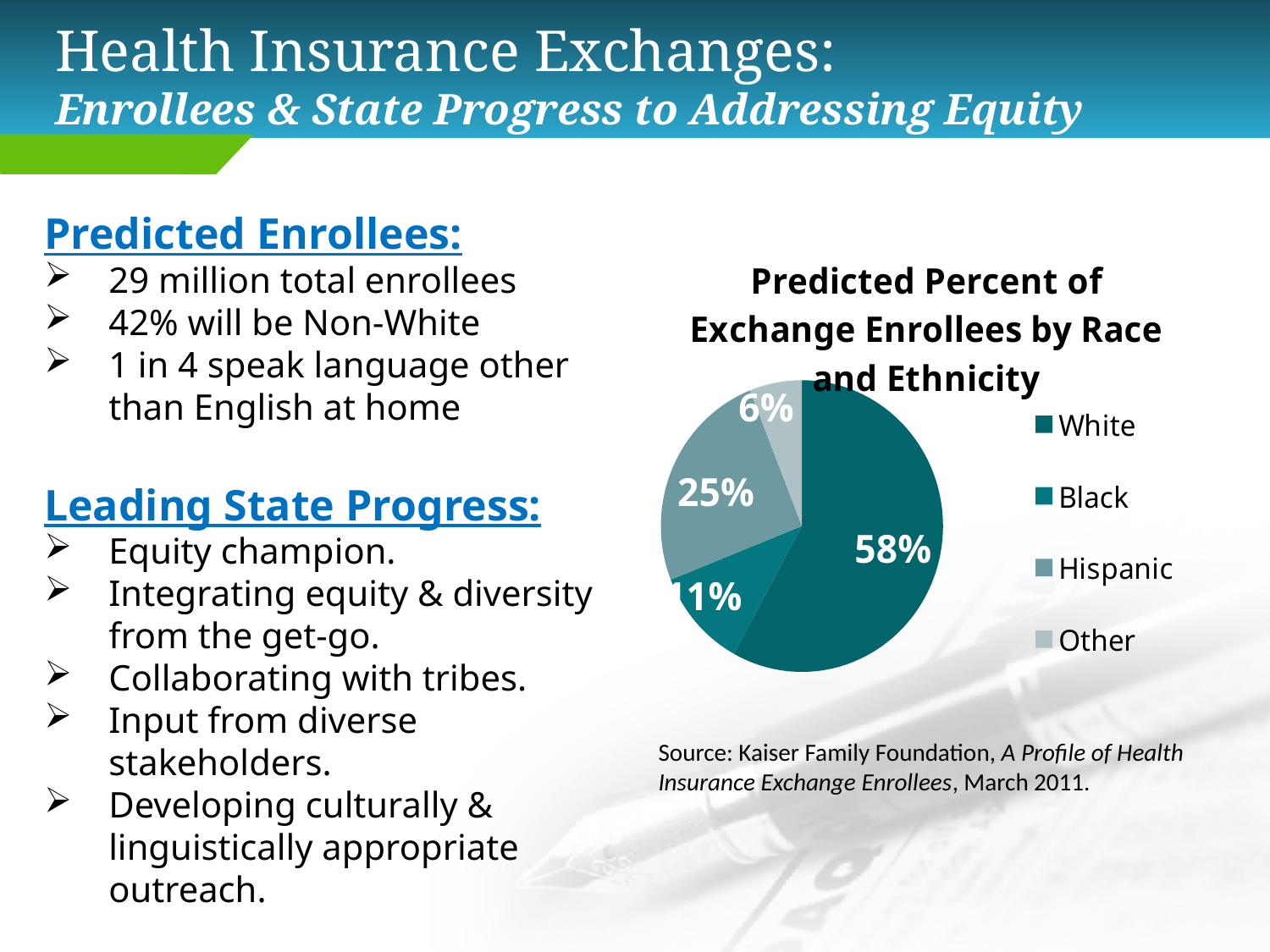
What is the title of the chart on the slide? Predicted Percent of Exchange Enrollees by Race and Ethnicity How many entries does the pie chart legend list? 4 Which race/ethnicity group has the largest share of predicted exchange enrollees? White Which race/ethnicity group has the smallest share of predicted exchange enrollees? Other What percentage of predicted exchange enrollees fall into the Other category? 6% What percentage of predicted exchange enrollees are Hispanic? 25% What percentage of predicted exchange enrollees are White? 58% Which is larger, the Hispanic share or the Other share? Hispanic What share of the pie does the White slice represent? 58% How many percentage points larger is the White share than the Hispanic share? 33 percentage points What type of chart is used to show predicted exchange enrollees by race and ethnicity? Pie chart How many race/ethnicity categories are shown in the pie chart? 4